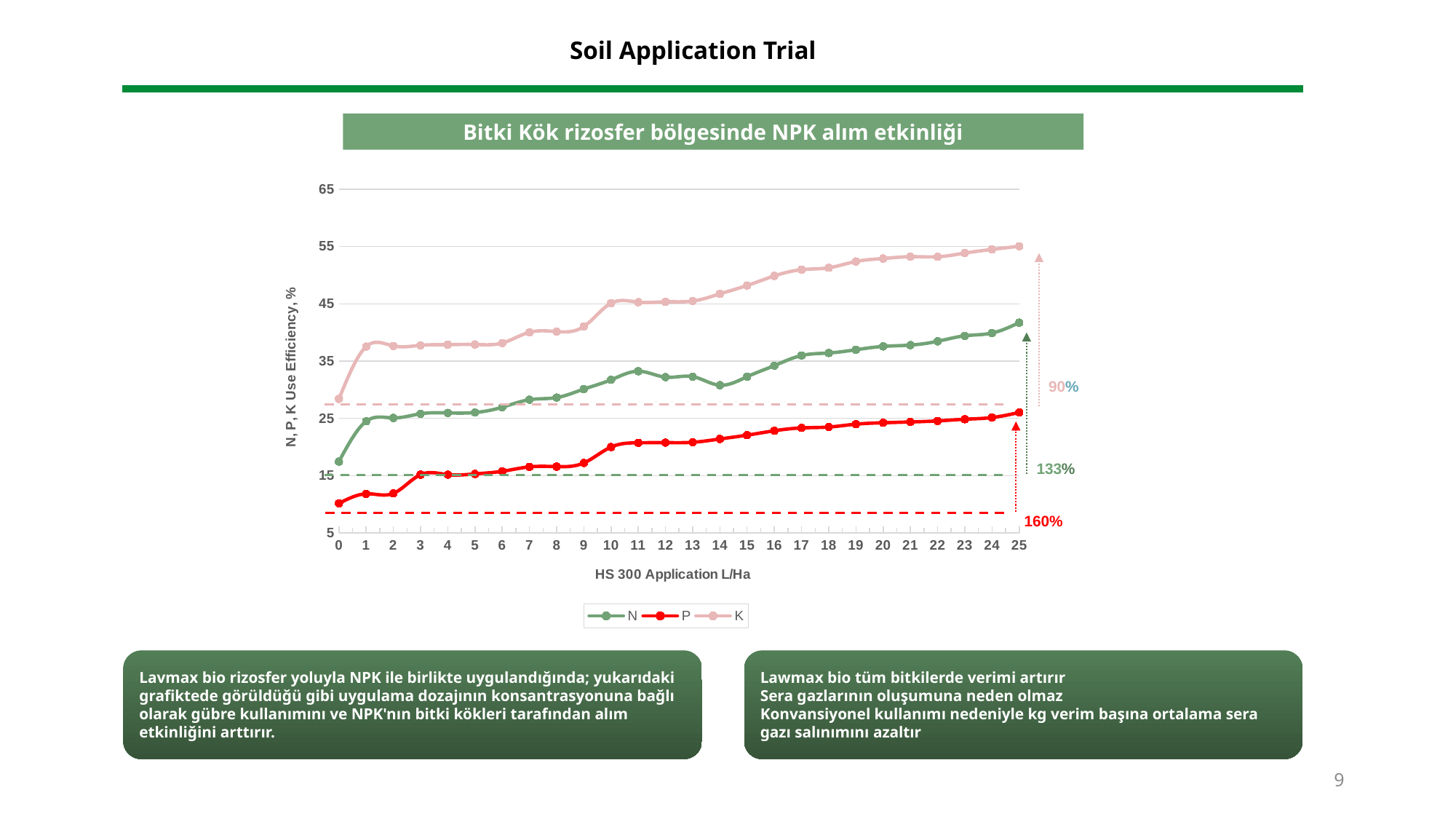
What kind of chart is shown on the slide? line chart Is the value for N at 0 L/Ha greater or less than 25? less What percentage increase is annotated for the P series on the right side of the chart? 160% What is the title of the x axis? HS 300 Application L/Ha Is the value for K at 25 L/Ha greater or less than 45? greater How many x-axis points (application levels) are plotted for each series? 26 Do the values of the K series rise or fall as the HS 300 application increases along the x axis? rise How many series does the legend list? 3 At an application of 25 L/Ha, which series is larger, N or P? N Which series has the lowest value at an application of 0 L/Ha? P Is the value for P at 25 L/Ha greater or less than 35? less Which series has the highest value at an application of 25 L/Ha? K